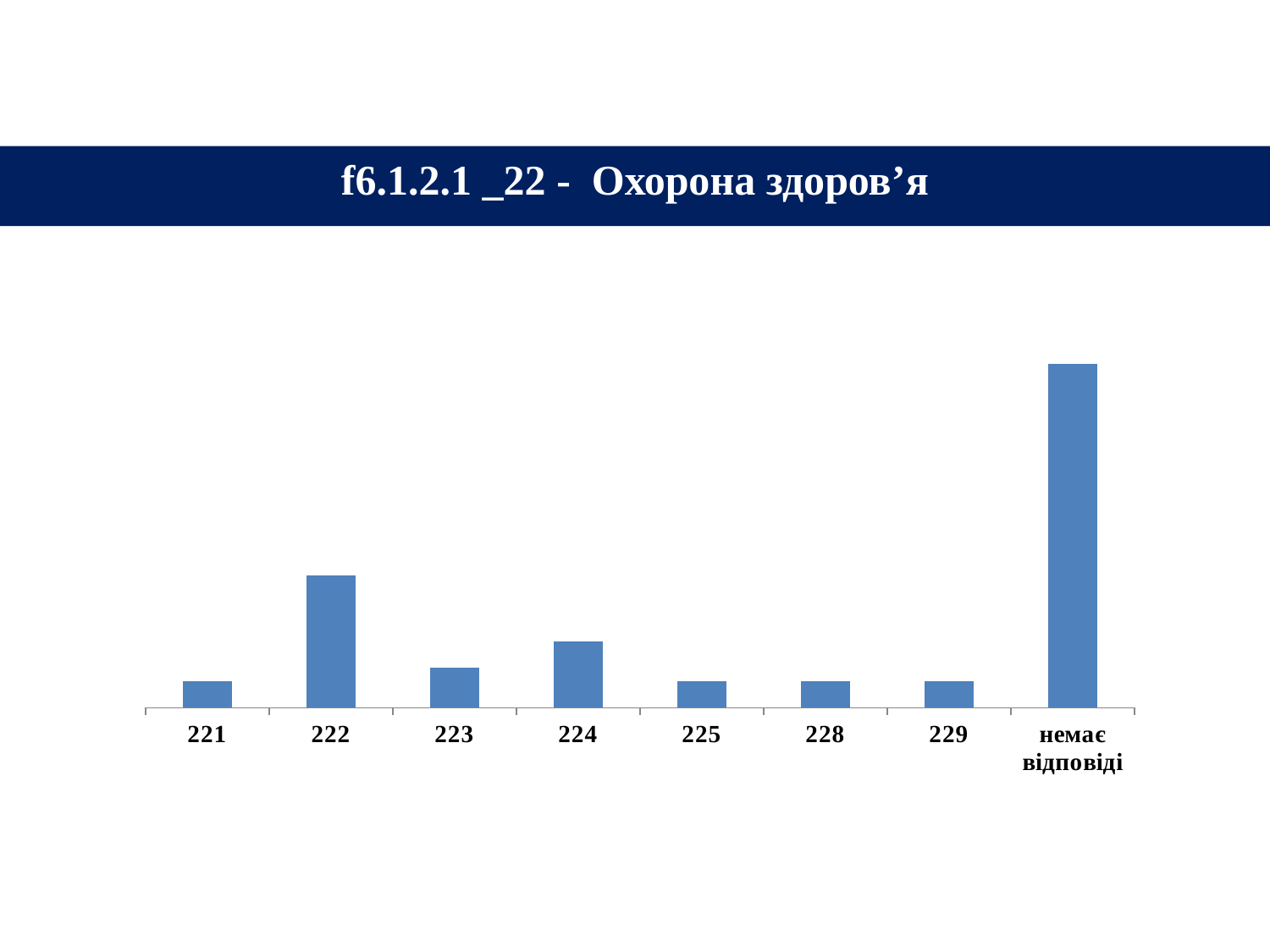
What is the title of the slide? f6.1.2.1 _22 - Охорона здоров’я What is the label of the last category on the x axis? немає відповіді Which category has the highest bar? немає відповіді Which is larger, the value for 222 or the value for 224? 222 Among the numbered categories (221 to 229), which has the highest bar? 222 Which is larger, the value for 223 or the value for 224? 224 Which is larger, the value for 223 or the value for 225? 223 How many categories are shown on the x axis? 8 What type of chart is shown on the slide? bar chart